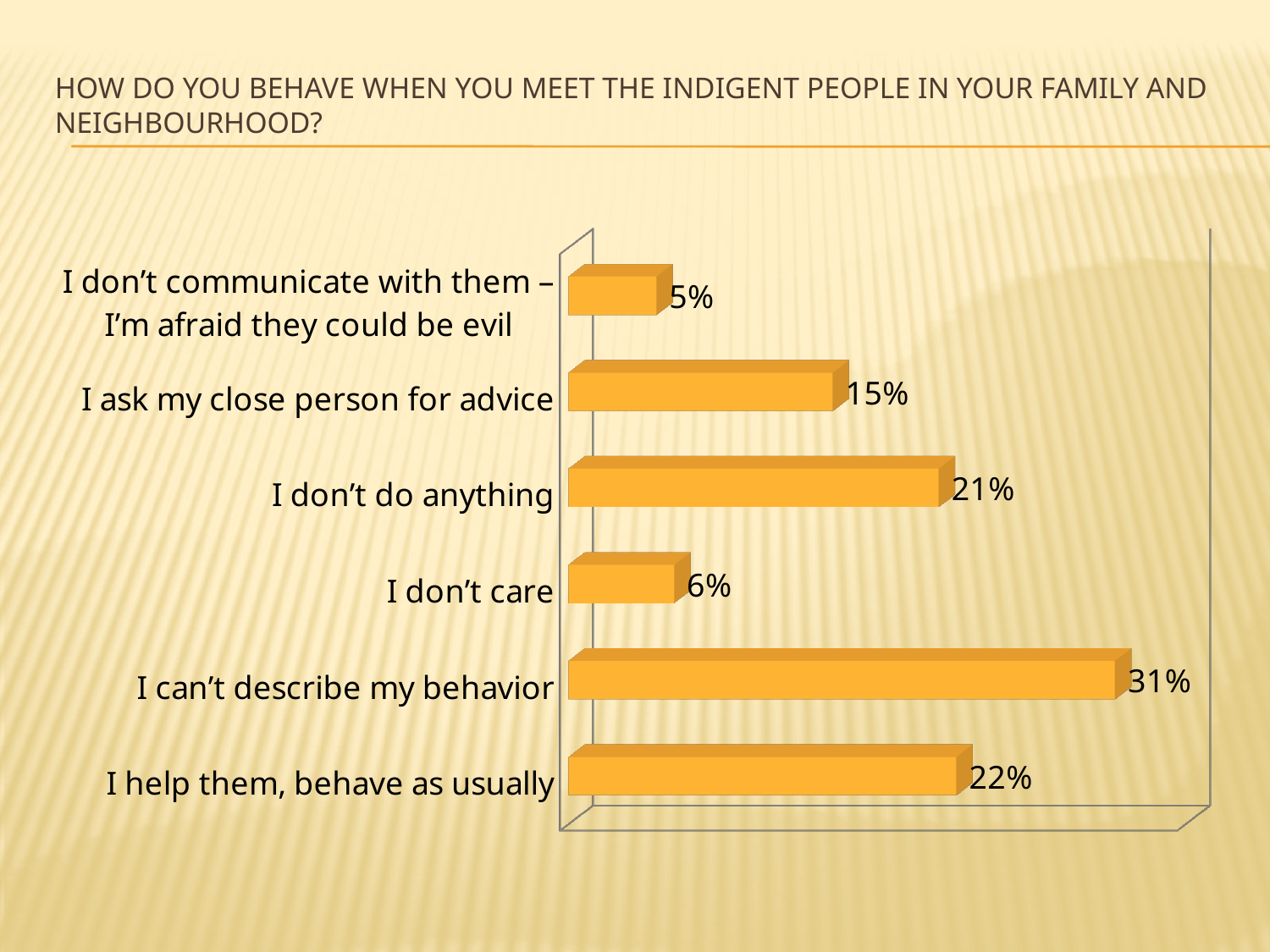
How many response categories are shown in the chart? 6 What is the value for "I ask my close person for advice"? 15% What is the value for "I don't do anything"? 21% What kind of chart is shown on the slide? Bar chart Which is larger: "I don't care" or "I don't communicate with them – I'm afraid they could be evil"? I don't care What colour are the bars in the chart? Orange What is the difference between "I don't do anything" and "I ask my close person for advice"? 6% Which response has the highest percentage? I can't describe my behavior Which response has the lowest percentage? I don't communicate with them – I'm afraid they could be evil What is the value for "I don't care"? 6% What percentage of respondents answered "I help them, behave as usually"? 22% What is the difference between "I can't describe my behavior" and "I help them, behave as usually"? 9%